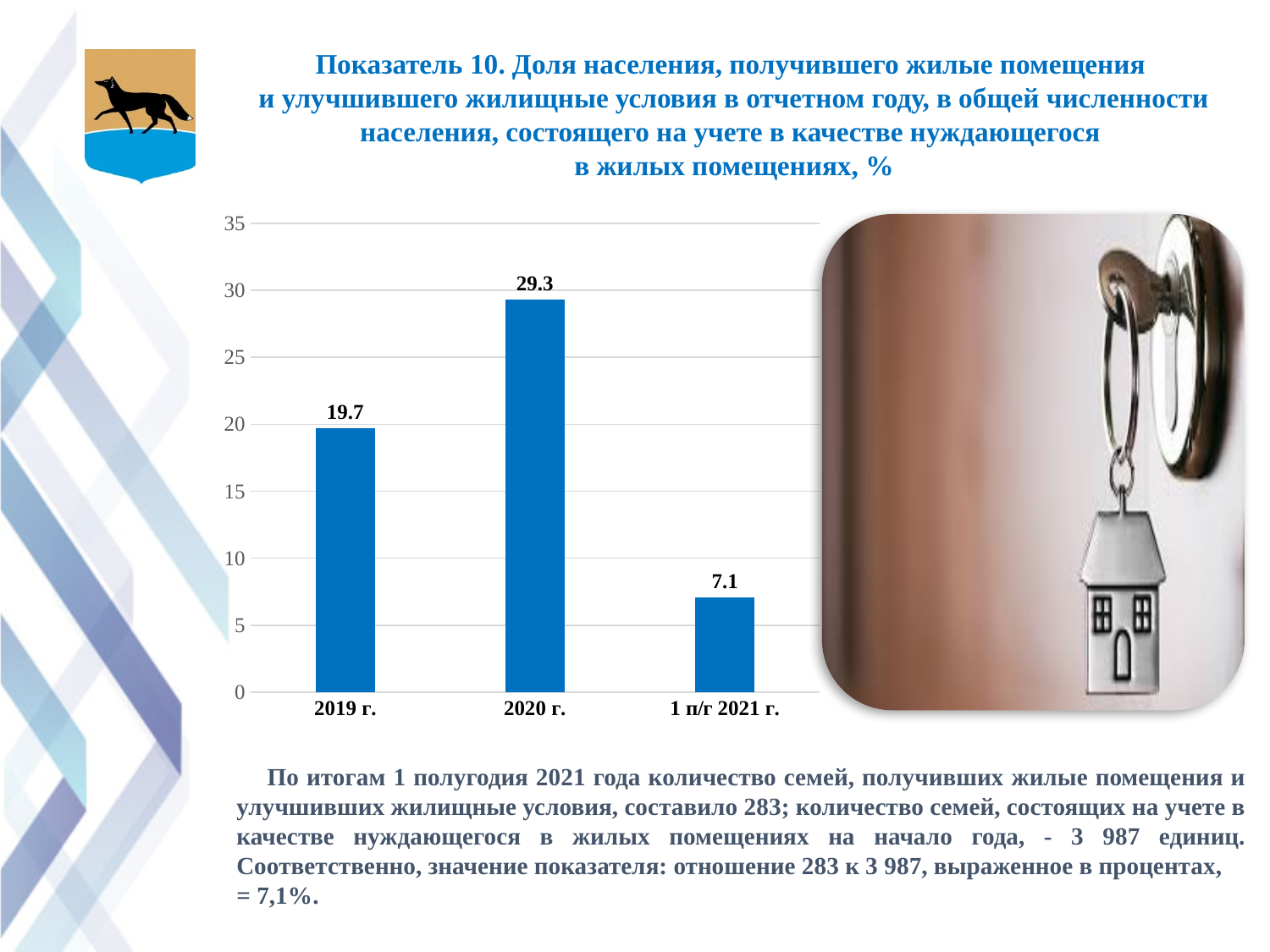
Which is larger, the value for 2019 г. or the value for 1 п/г 2021 г.? 2019 г. Which category has the highest value? 2020 г. What kind of chart is shown on the slide? bar chart Which category has the lowest value? 1 п/г 2021 г. What is the difference between the values for 2020 г. and 2019 г.? 9.6 What is the maximum value shown on the vertical axis? 35 What is the value for 2019 г.? 19.7 What is the value for 2020 г.? 29.3 Is the value for 2020 г. greater or less than 25? greater How many categories are shown on the x axis? 3 What is the difference between the values for 2019 г. and 1 п/г 2021 г.? 12.6 What is the value for 1 п/г 2021 г.? 7.1